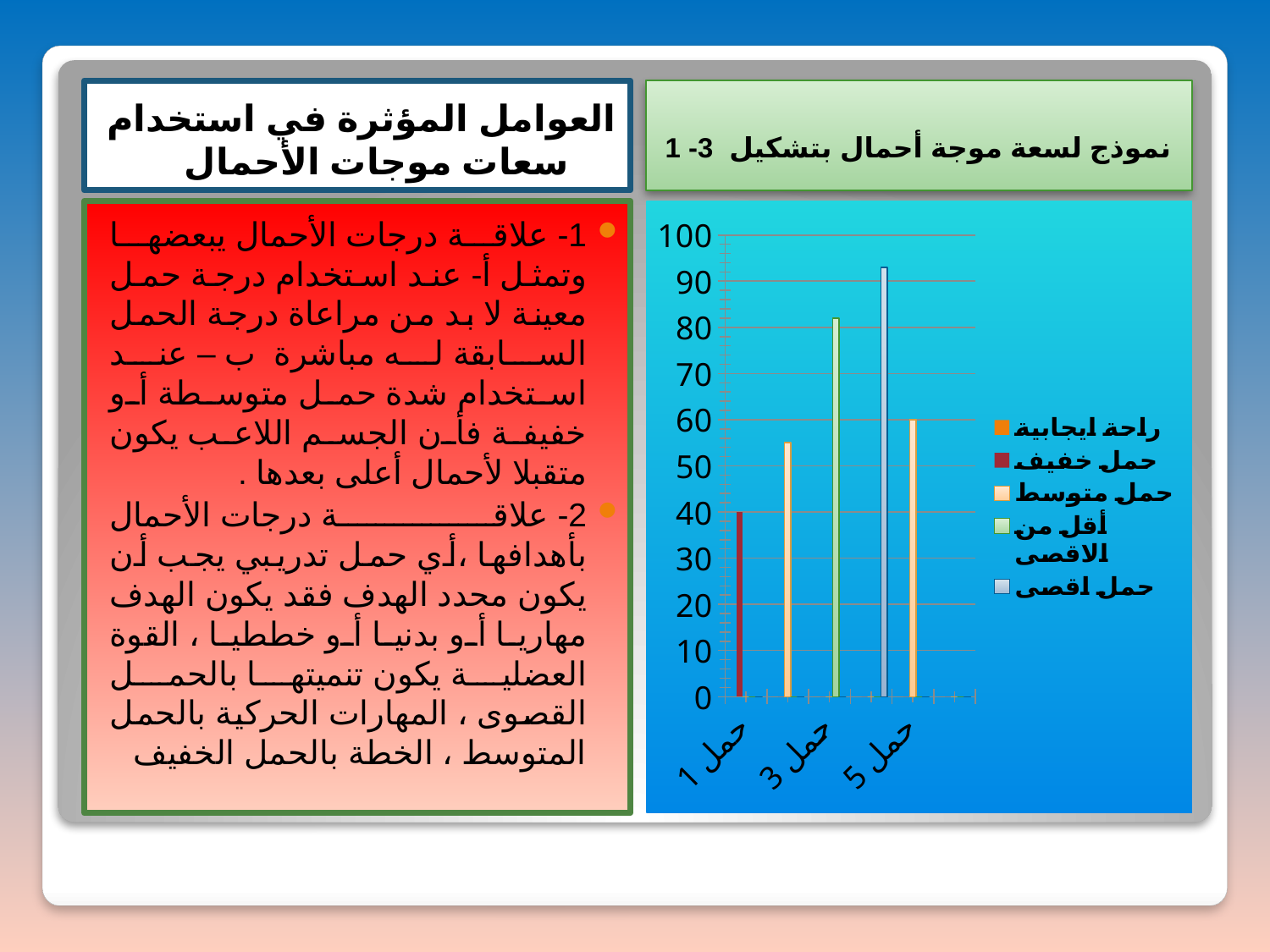
Is the value for حمل 1 greater or less than 50? less What is the title of the chart? نموذج لسعة موجة أحمال بتشكيل 3-1 Which is larger, the bar for حمل 1 or the bar for حمل 3? حمل 3 Which legend series has the shortest bar in the chart? حمل خفيف Which legend entry is shown in dark red? حمل خفيف Is the value for حمل 3 greater or less than 70? greater Is the value of the حمل اقصى bar greater or less than 80? greater Which legend series has the tallest bar in the chart? حمل اقصى How many series does the chart legend list? 5 How many bars are plotted in the chart? 5 What kind of chart is shown on the slide? bar chart